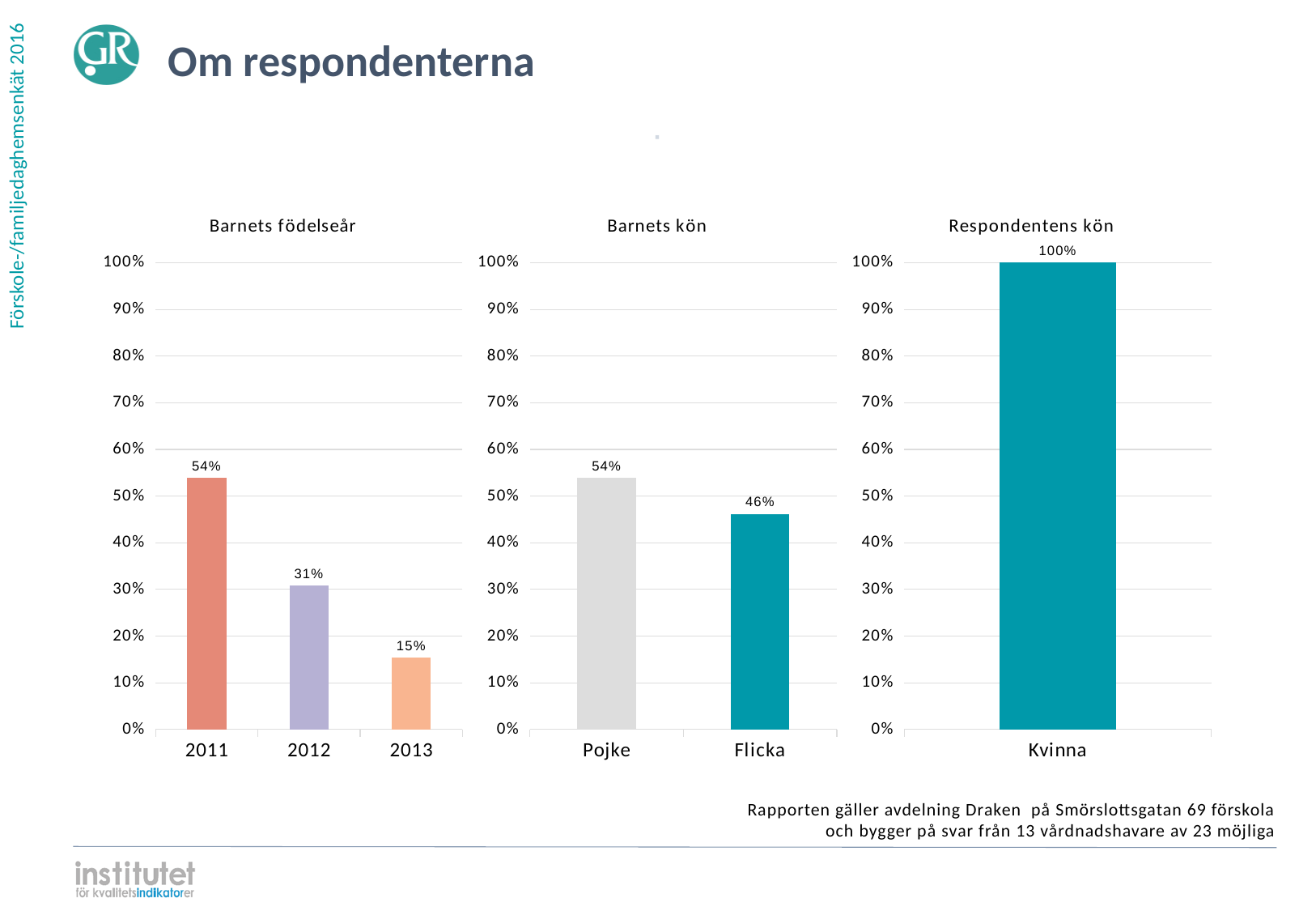
In the 'Barnets födelseår' chart, do the values rise or fall from 2011 to 2013? fall In the 'Respondentens kön' chart, what is the value for Kvinna? 100% In the 'Barnets födelseår' chart, what is the value for 2011? 54% In the 'Barnets kön' chart, what is the value for Flicka? 46% In the 'Barnets kön' chart, which is larger, Pojke or Flicka? Pojke In the 'Barnets födelseår' chart, how many categories are shown on the x axis? 3 In the 'Barnets födelseår' chart, what is the value for 2013? 15% In the 'Barnets kön' chart, what is the difference between Pojke and Flicka? 8% In the 'Barnets födelseår' chart, which year has the lowest value? 2013 In the 'Barnets födelseår' chart, what is the difference between the values for 2011 and 2012? 23% What kind of chart is the 'Respondentens kön' chart? bar chart What is the title of the chart on the left of the slide? Barnets födelseår